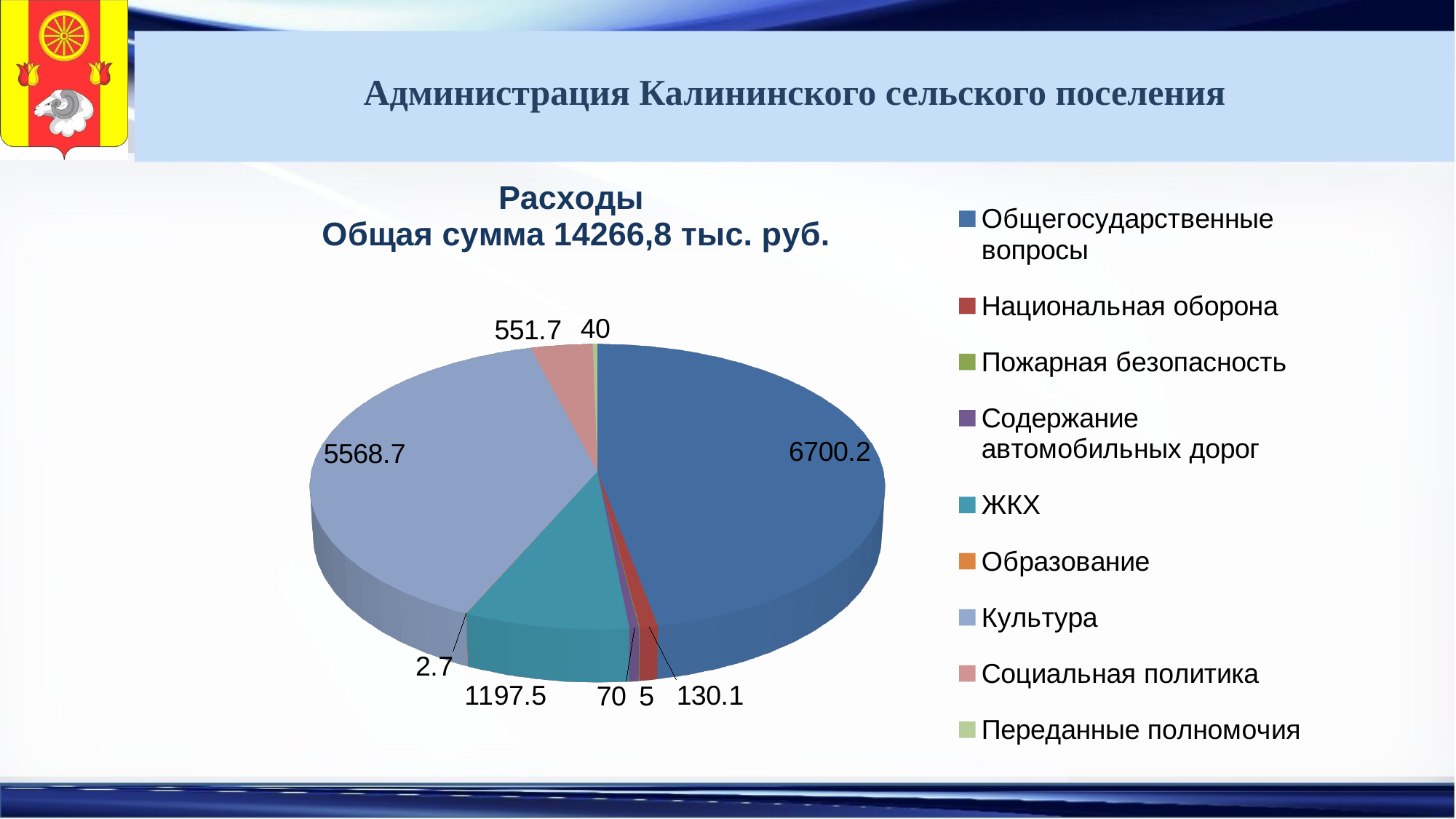
What is the value for ЖКХ? 1197.5 Which category has the smallest value? Образование What is the value for Национальная оборона? 130.1 What total sum is stated in the chart title? 14266,8 тыс. руб. What is the difference between the values for Общегосударственные вопросы and Культура? 1131.5 What is the value for Общегосударственные вопросы? 6700.2 What is the value for Социальная политика? 551.7 Which category has the largest slice of the pie? Общегосударственные вопросы What kind of chart is shown on the slide? pie chart How many categories does the legend list? 9 Which is larger, the value for ЖКХ or the value for Социальная политика? ЖКХ What is the value for Культура? 5568.7